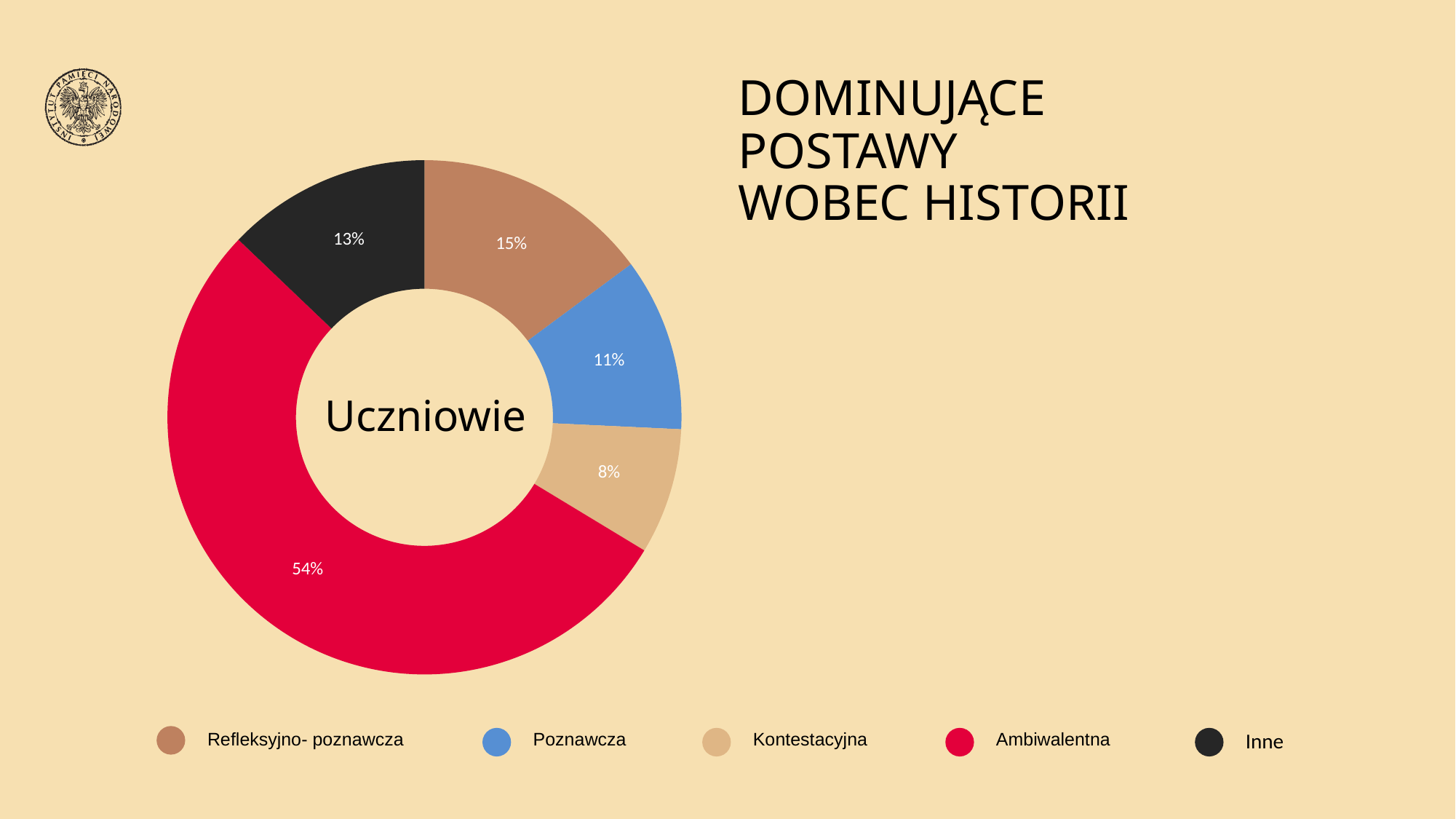
What is the value shown for Inne? 13% What is the value shown for Refleksyjno- poznawcza? 15% How many categories does the chart show? 5 Which category has the smallest slice? Kontestacyjna Which is larger, Refleksyjno- poznawcza or Poznawcza? Refleksyjno- poznawcza What is the value shown for Poznawcza? 11% Which category has the largest slice? Ambiwalentna What kind of chart is shown on the slide? Donut (pie) chart What is the value shown for Kontestacyjna? 8% What label is written in the centre of the donut chart? Uczniowie What share of the donut chart does Ambiwalentna take? 54% What is the difference between the Ambiwalentna and Inne values? 41%